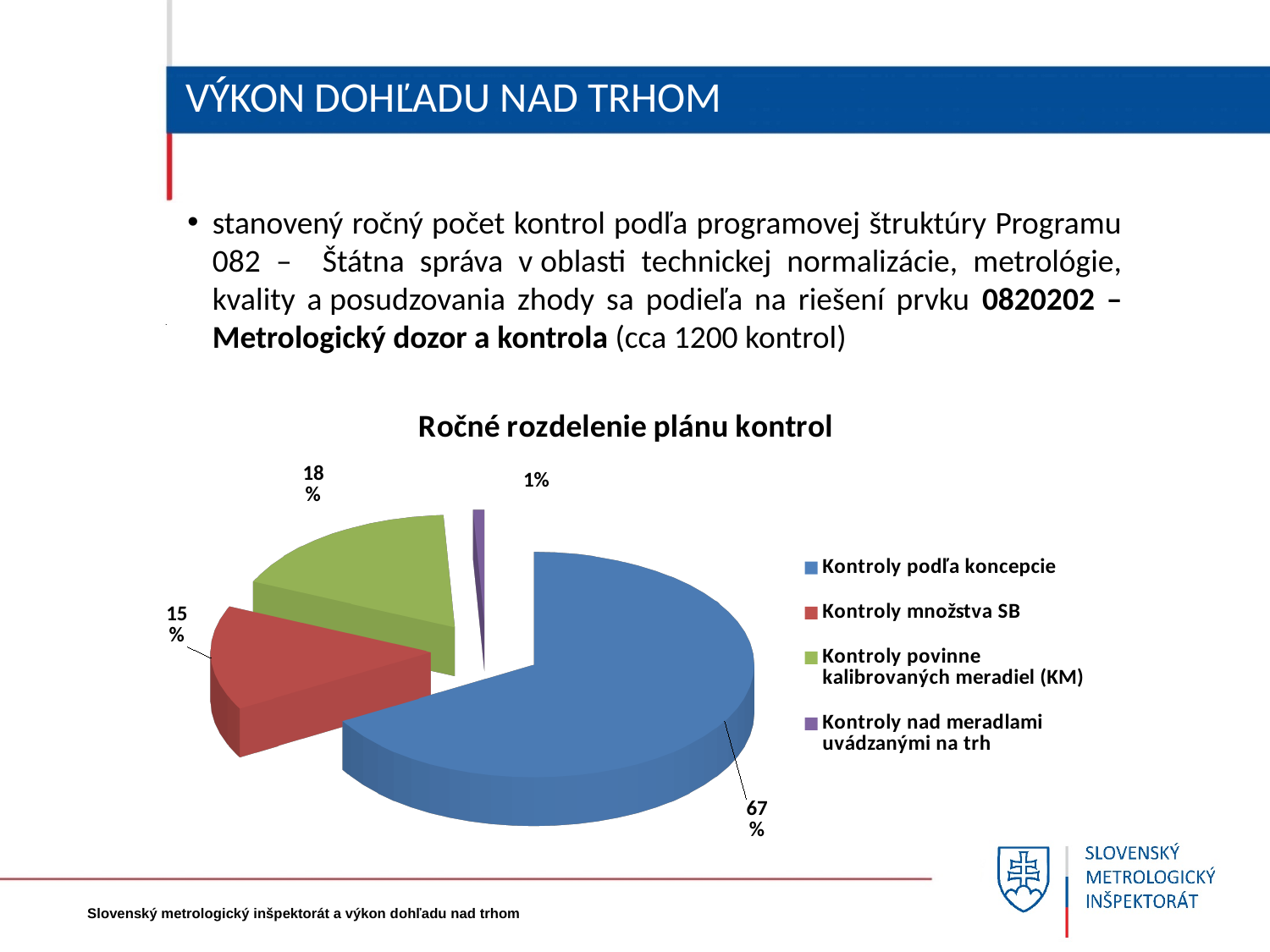
What is the title of the chart? Ročné rozdelenie plánu kontrol What share of the pie is 'Kontroly nad meradlami uvádzanými na trh'? 1% What kind of chart is shown on the slide? pie chart What share of the pie is 'Kontroly množstva SB'? 15% Which category has the smallest share of the pie? Kontroly nad meradlami uvádzanými na trh Which category has the largest share of the pie? Kontroly podľa koncepcie Which is larger: the share for 'Kontroly množstva SB' or for 'Kontroly povinne kalibrovaných meradiel (KM)'? Kontroly povinne kalibrovaných meradiel (KM) How many entries does the legend list? 4 What share of the pie is 'Kontroly podľa koncepcie'? 67% What is the difference in percentage points between 'Kontroly podľa koncepcie' and 'Kontroly povinne kalibrovaných meradiel (KM)'? 49 percentage points How many slices does the pie chart have? 4